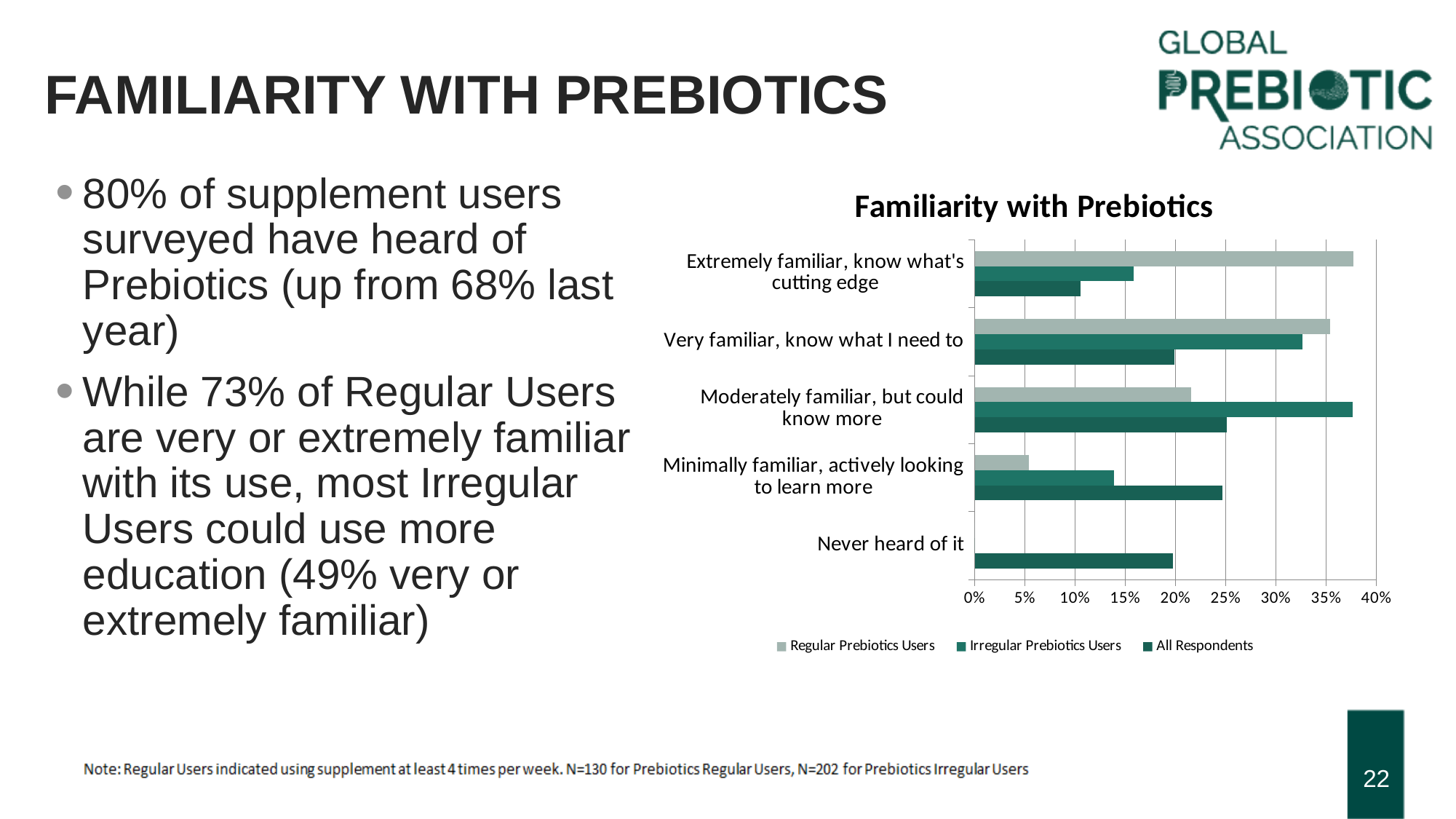
How many familiarity categories are shown on the chart? 5 In 'Extremely familiar, know what's cutting edge', which is larger: Regular Prebiotics Users or All Respondents? Regular Prebiotics Users Is the value for Regular Prebiotics Users in 'Minimally familiar, actively looking to learn more' greater or less than 10%? less Which category has the lowest value for All Respondents? Extremely familiar, know what's cutting edge In 'Moderately familiar, but could know more', which is larger: Regular Prebiotics Users or Irregular Prebiotics Users? Irregular Prebiotics Users How many series does the legend of the chart list? 3 Is the value for Irregular Prebiotics Users in 'Very familiar, know what I need to' greater or less than 30%? greater Which category has the highest value for Irregular Prebiotics Users? Moderately familiar, but could know more What kind of chart is shown on the slide? Bar chart Is the value for Regular Prebiotics Users in 'Extremely familiar, know what's cutting edge' greater or less than 30%? greater What is the title of the chart? Familiarity with Prebiotics